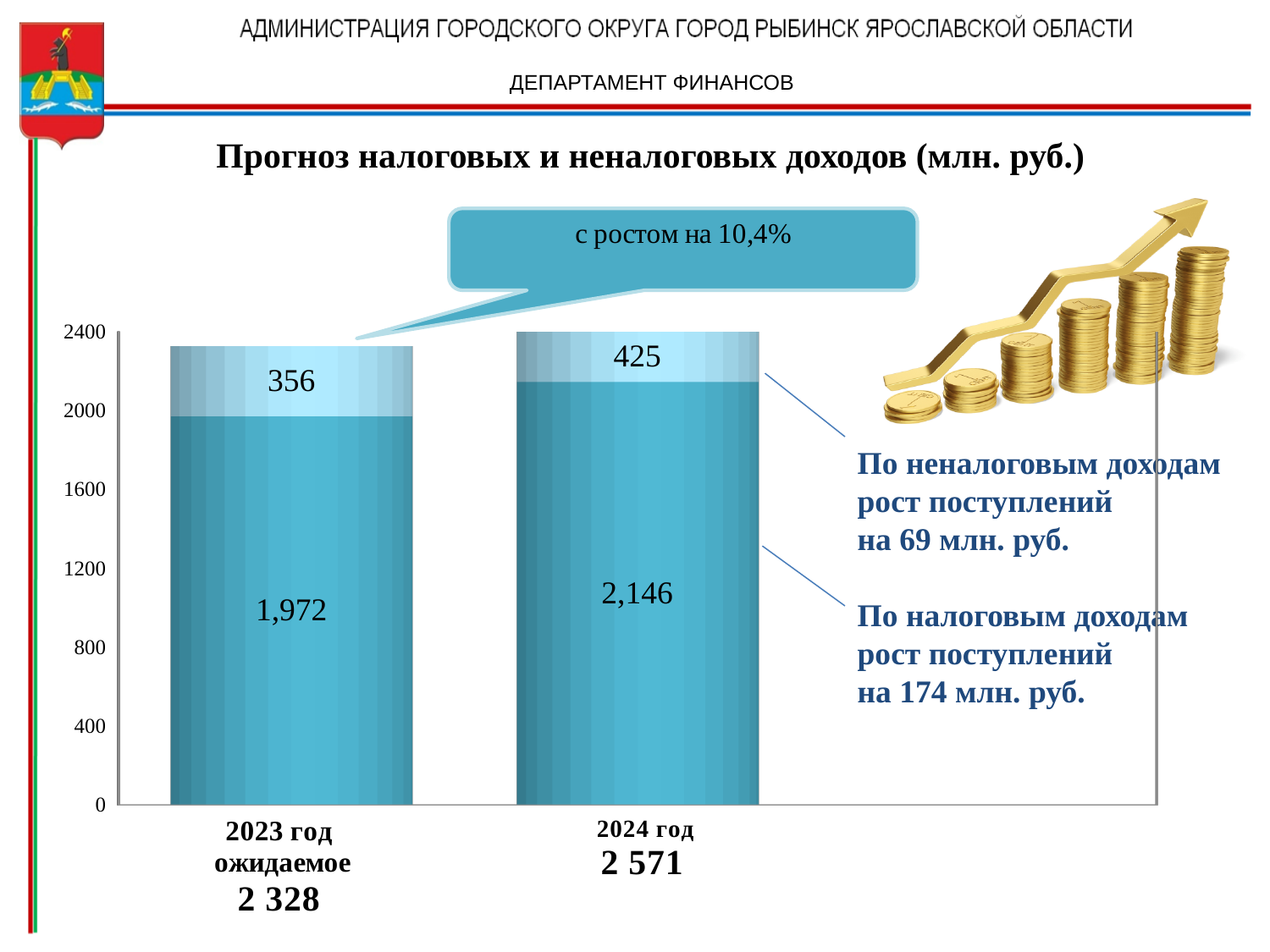
What is the value of the lower (tax revenue) segment of the bar for 2023 год ожидаемое? 1,972 What is the total of the stacked bar for 2023 год ожидаемое? 2 328 What is the value of the lower segment of the bar for 2024 год? 2,146 Do the bar totals rise or fall from 2023 год ожидаемое to 2024 год? rise Which bar has the larger total, 2023 год ожидаемое or 2024 год? 2024 год What is the difference between the lower segments of the 2024 год bar and the 2023 год ожидаемое bar? 174 What is the total of the stacked bar for 2024 год? 2 571 What is the value of the upper (non-tax revenue) segment of the bar for 2024 год? 425 How many bars (categories) are plotted in the chart? 2 What type of chart is shown on the slide? bar chart What is the title of the chart? Прогноз налоговых и неналоговых доходов (млн. руб.) What is the value of the upper segment of the bar for 2023 год ожидаемое? 356